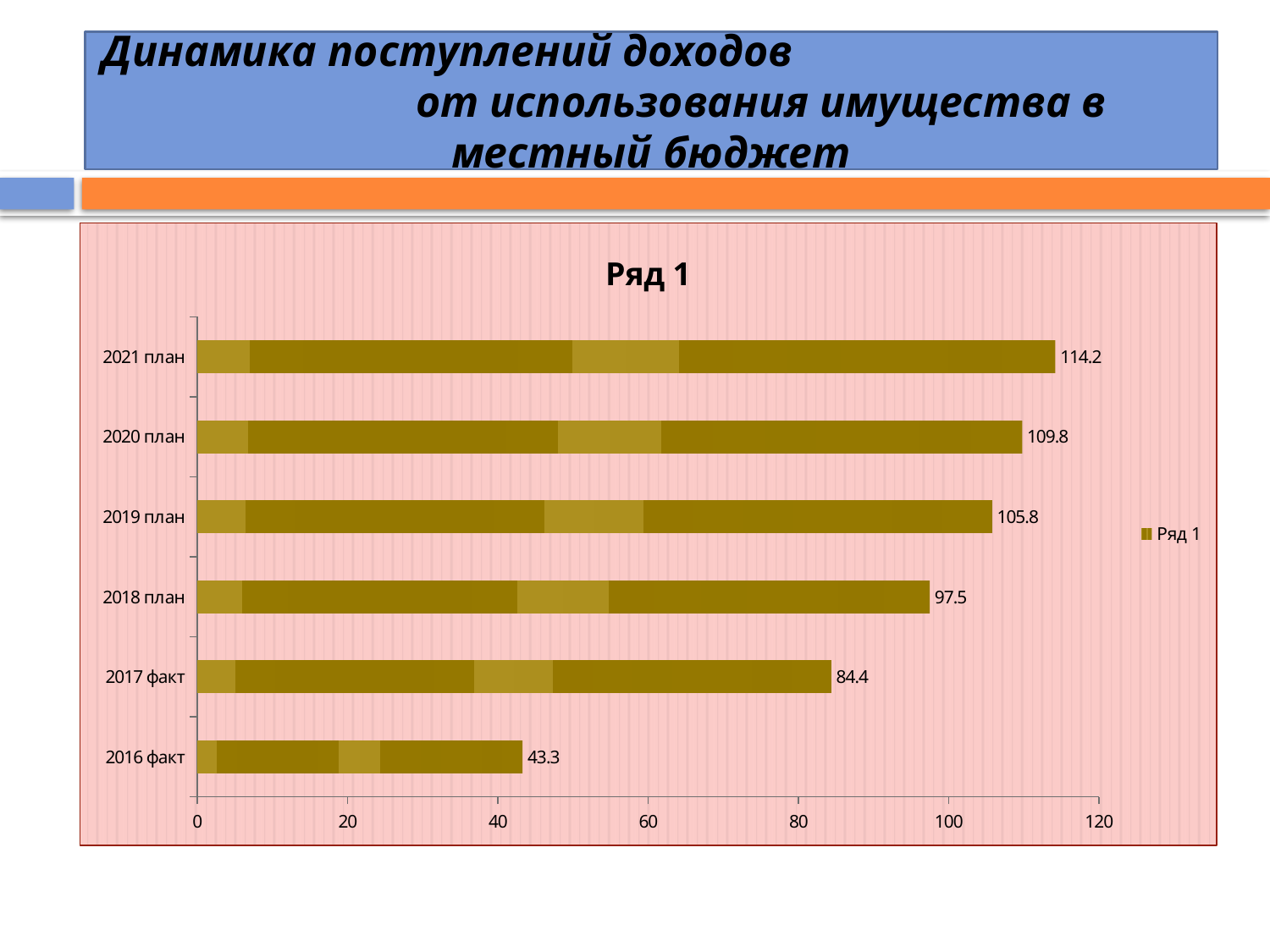
Which category has the lowest value? 2016 факт What is the value for 2021 план? 114.2 What is the value for 2016 факт? 43.3 What is the difference between the values for 2021 план and 2020 план? 4.4 What is the difference between the values for 2017 факт and 2016 факт? 41.1 Is the value for 2017 факт greater or less than 100? less Which is larger, the value for 2019 план or the value for 2018 план? 2019 план How many categories are shown in the chart? 6 What kind of chart is shown on the slide? bar chart What is the title of the chart? Ряд 1 Which category has the highest value? 2021 план What is the value for 2018 план? 97.5